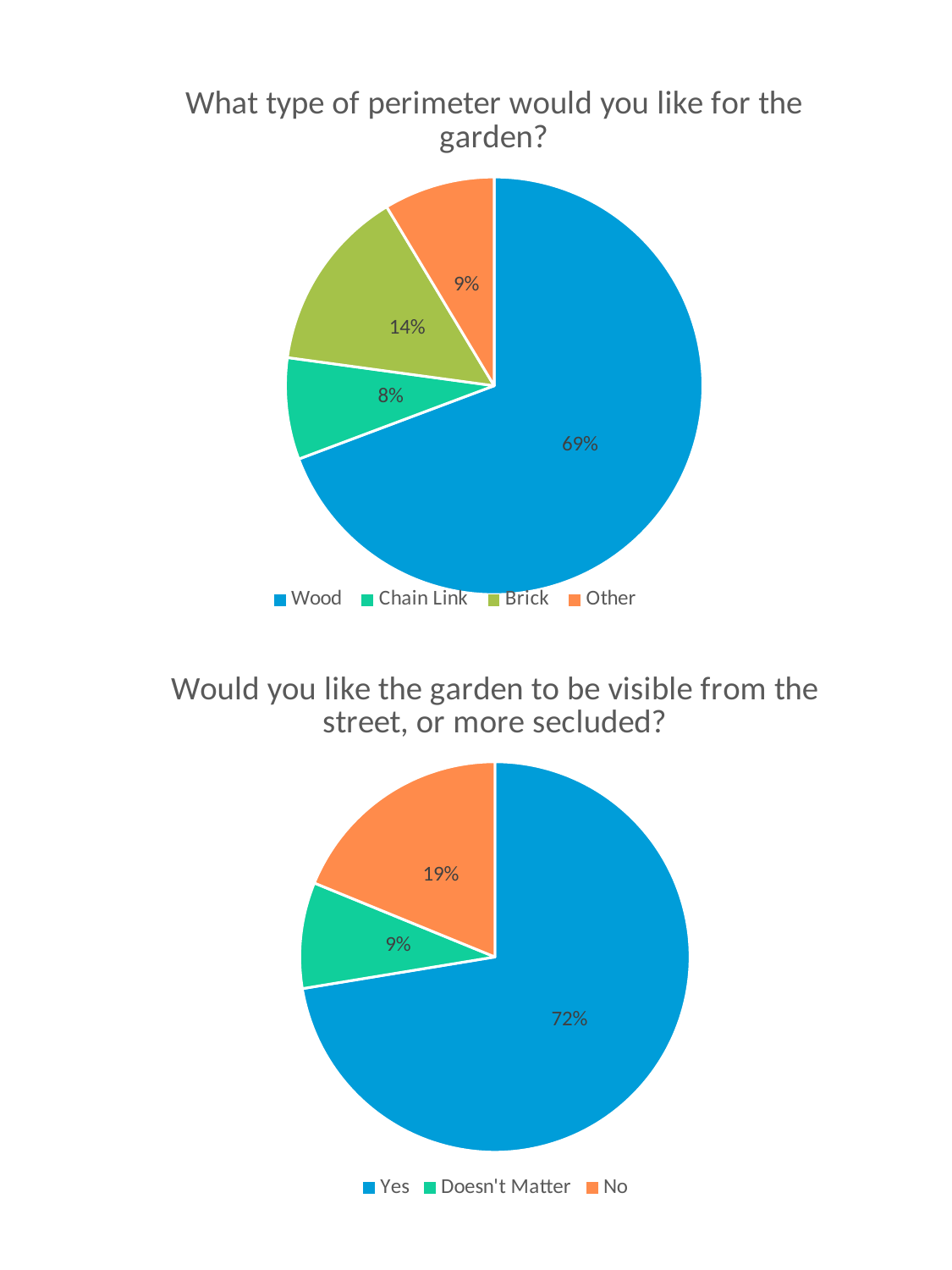
In the chart titled "Would you like the garden to be visible from the street, or more secluded?", which category has the smallest slice? Doesn't Matter In the chart titled "What type of perimeter would you like for the garden?", which is larger, Chain Link or Other? Other In the chart titled "Would you like the garden to be visible from the street, or more secluded?", what is the difference in percentage points between Yes and No? 53 In the chart titled "What type of perimeter would you like for the garden?", what share of the pie is Wood? 69% In the chart titled "Would you like the garden to be visible from the street, or more secluded?", what percentage is shown for No? 19% In the chart titled "What type of perimeter would you like for the garden?", which category has the largest slice? Wood In the chart titled "What type of perimeter would you like for the garden?", what is the difference in percentage points between Brick and Other? 5 In the chart titled "What type of perimeter would you like for the garden?", how many categories does the legend list? 4 In the chart titled "Would you like the garden to be visible from the street, or more secluded?", what share of the pie is Yes? 72% In the chart titled "What type of perimeter would you like for the garden?", what percentage is shown for Brick? 14% What kind of chart is the bottom chart on the slide? Pie chart In the chart titled "What type of perimeter would you like for the garden?", which category has the smallest slice? Chain Link